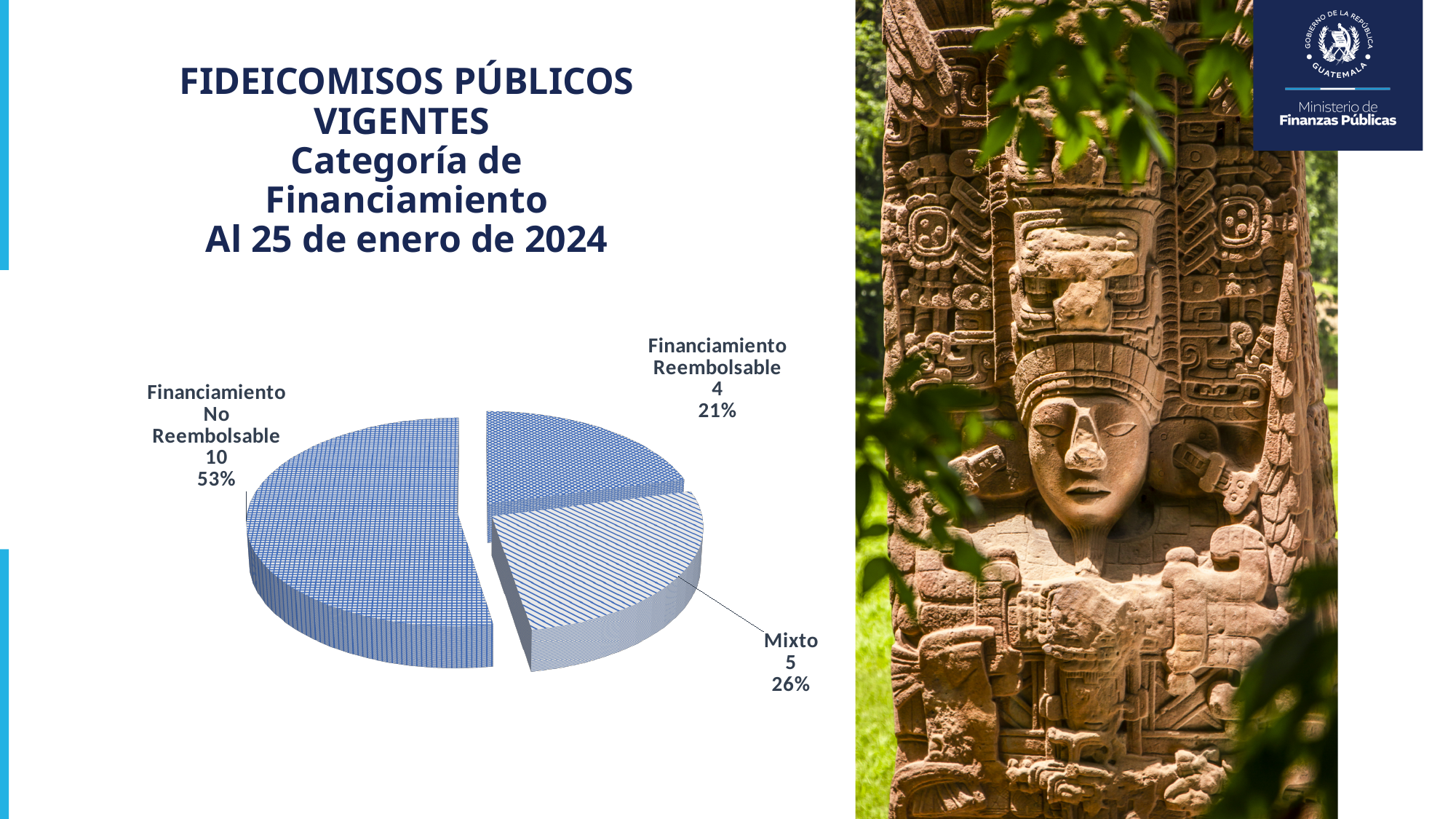
What kind of chart is shown on the slide? Pie chart Which is larger, the Mixto count or the Financiamiento Reembolsable count? Mixto What percentage share does the Mixto slice represent? 26% How many fideicomisos are in the Mixto category? 5 How many fideicomisos are in the Financiamiento No Reembolsable category? 10 What percentage share does Financiamiento Reembolsable have? 21% What is the difference in count between Financiamiento No Reembolsable and Mixto? 5 Which category has the largest slice of the pie? Financiamiento No Reembolsable Which category has the smallest slice of the pie? Financiamiento Reembolsable How many categories are shown in the pie chart? 3 What date is given in the chart title? 25 de enero de 2024 What is the total number of fideicomisos across all three categories? 19